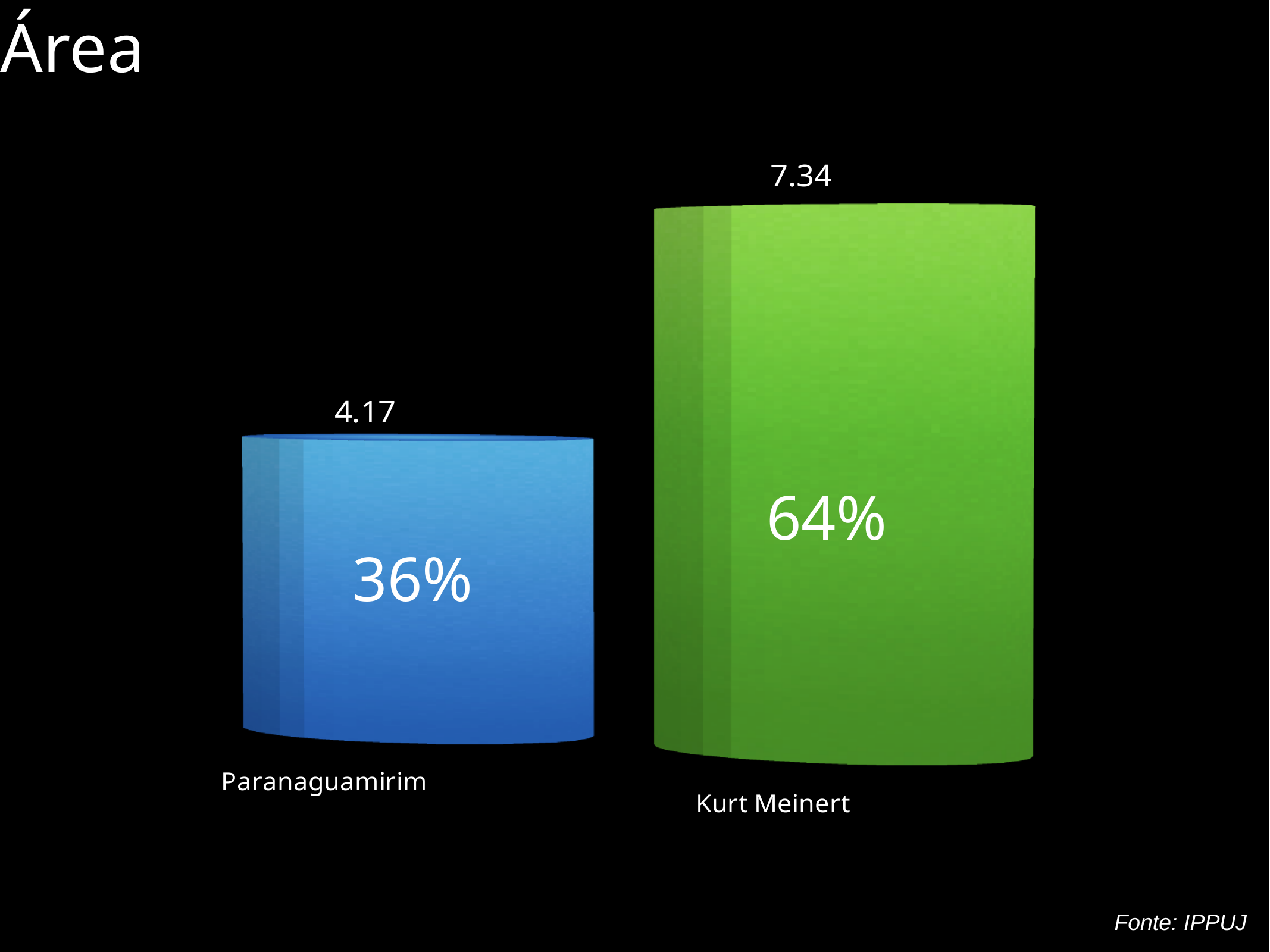
What is the value shown for Paranaguamirim? 4.17 By how many percentage points does Kurt Meinert's share exceed Paranaguamirim's? 28% What percentage is shown on the Kurt Meinert bar? 64% What is the value shown for Kurt Meinert? 7.34 What is the difference between the values for Kurt Meinert and Paranaguamirim? 3.17 Which category has the highest value? Kurt Meinert What percentage is shown on the Paranaguamirim bar? 36% What kind of chart is shown on the slide? Bar chart Which is larger, the value for Paranaguamirim or the value for Kurt Meinert? Kurt Meinert What is the title of the chart? Área Which category has the lowest value? Paranaguamirim How many categories are shown in the chart? 2